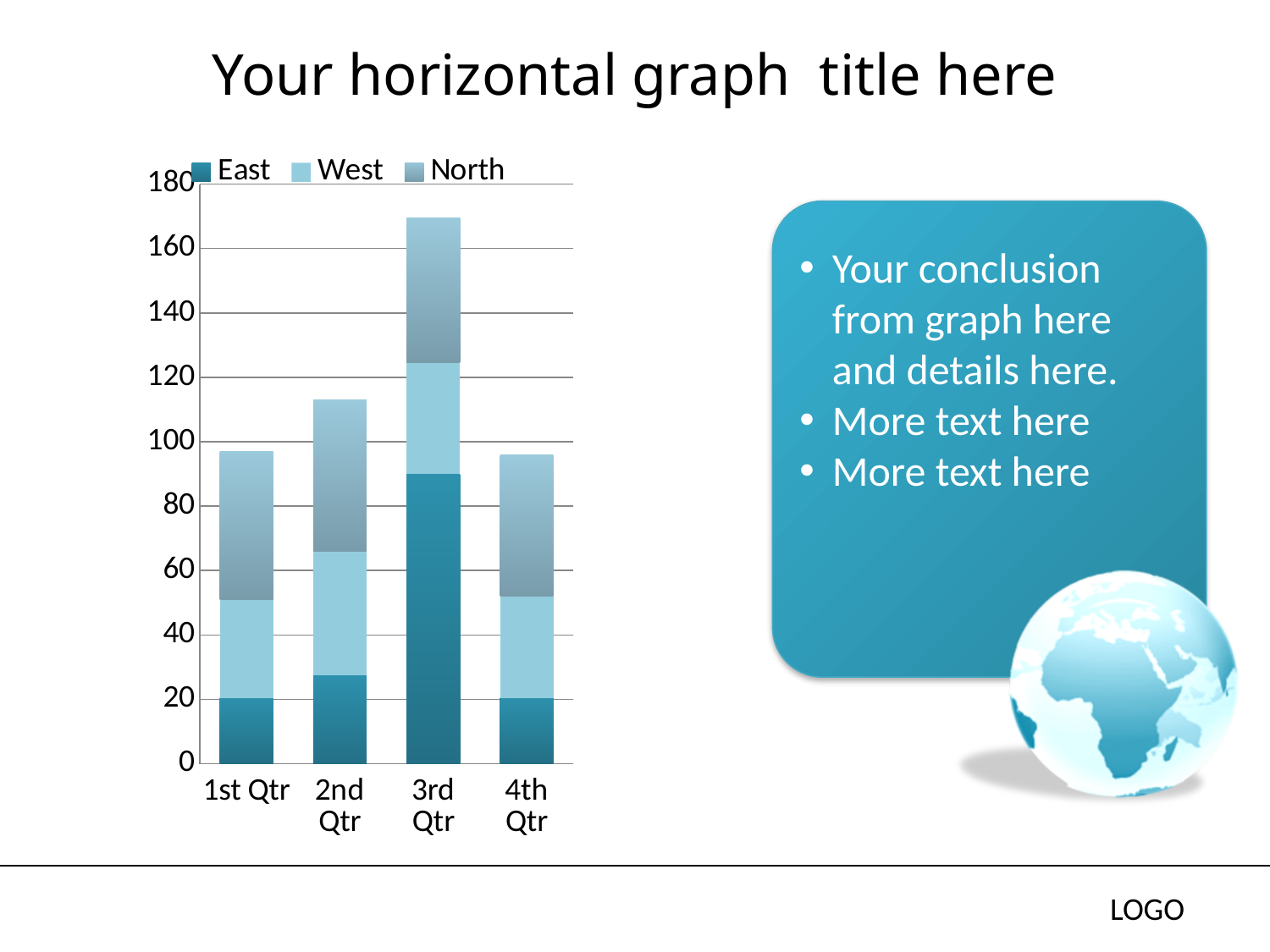
Is the total stacked value for 2nd Qtr greater or less than 100? greater How many quarters are shown on the x axis? 4 Which quarter has the tallest stacked bar overall? 3rd Qtr Which has the larger total stacked value, 2nd Qtr or 4th Qtr? 2nd Qtr Is the East value for 3rd Qtr greater or less than 80? greater Is the total stacked value for 3rd Qtr greater or less than 160? greater What are the three series names listed in the legend? East, West, North Which quarter has the largest East value? 3rd Qtr Which has the larger East value, 3rd Qtr or 2nd Qtr? 3rd Qtr What kind of chart is shown on the slide? stacked bar chart How many series does the legend list? 3